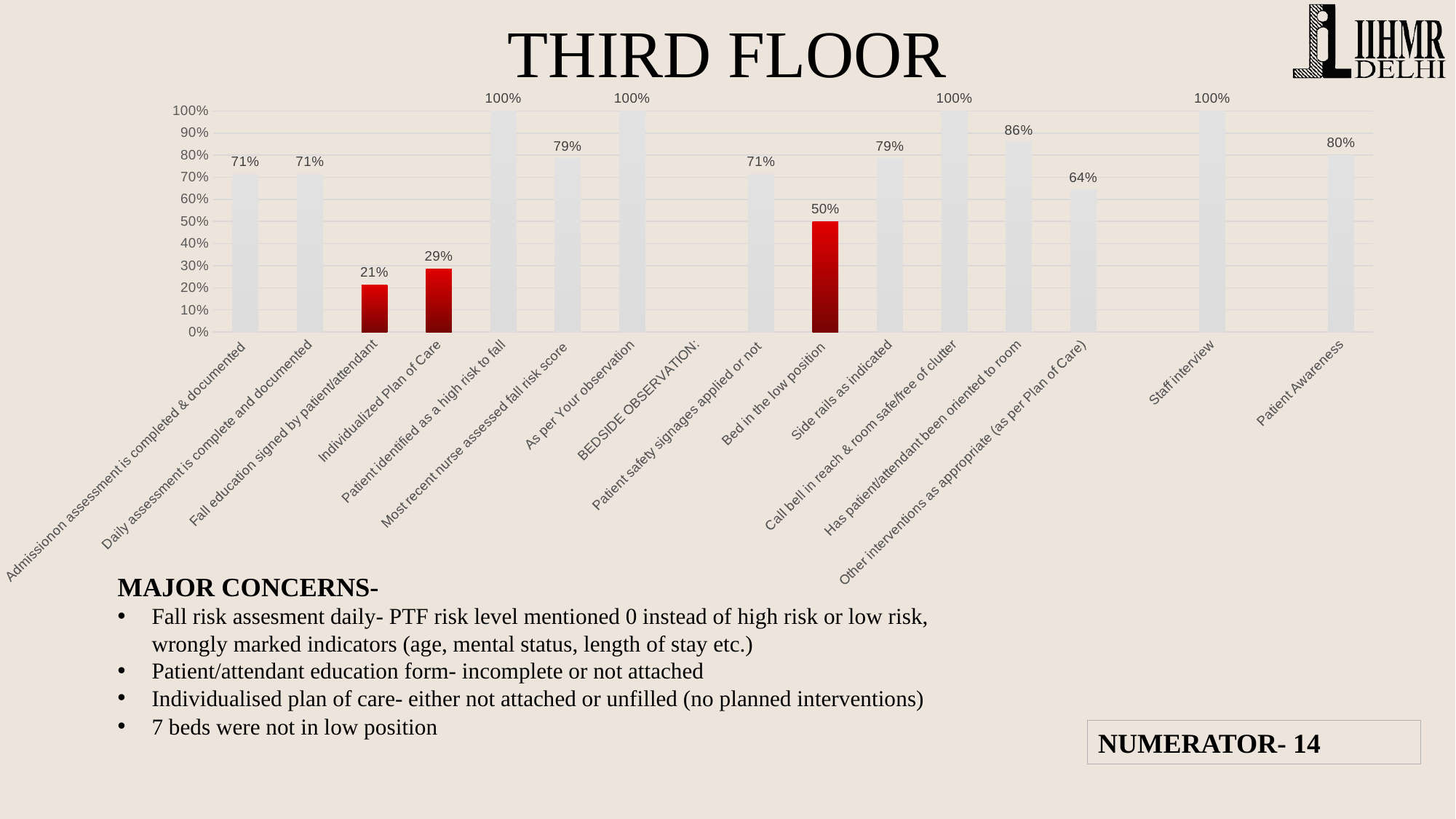
What is the value for 'Fall education signed by patient/attendant'? 21% What is the value for 'Patient Awareness'? 80% How many bars reach 100%? 4 What is the difference between 'Staff interview' and 'Patient Awareness'? 20% Which category has the lowest value? Fall education signed by patient/attendant Which is larger, 'Side rails as indicated' or 'Patient safety signages applied or not'? Side rails as indicated What is the difference between 'Individualized Plan of Care' and 'Fall education signed by patient/attendant'? 8% What is the value for 'Has patient/attendant been oriented to room'? 86% How many bars are coloured red? 3 What is the value for 'Bed in the low position'? 50% What is the value for 'Other interventions as appropriate (as per Plan of Care)'? 64% What kind of chart is shown on the slide? Bar chart